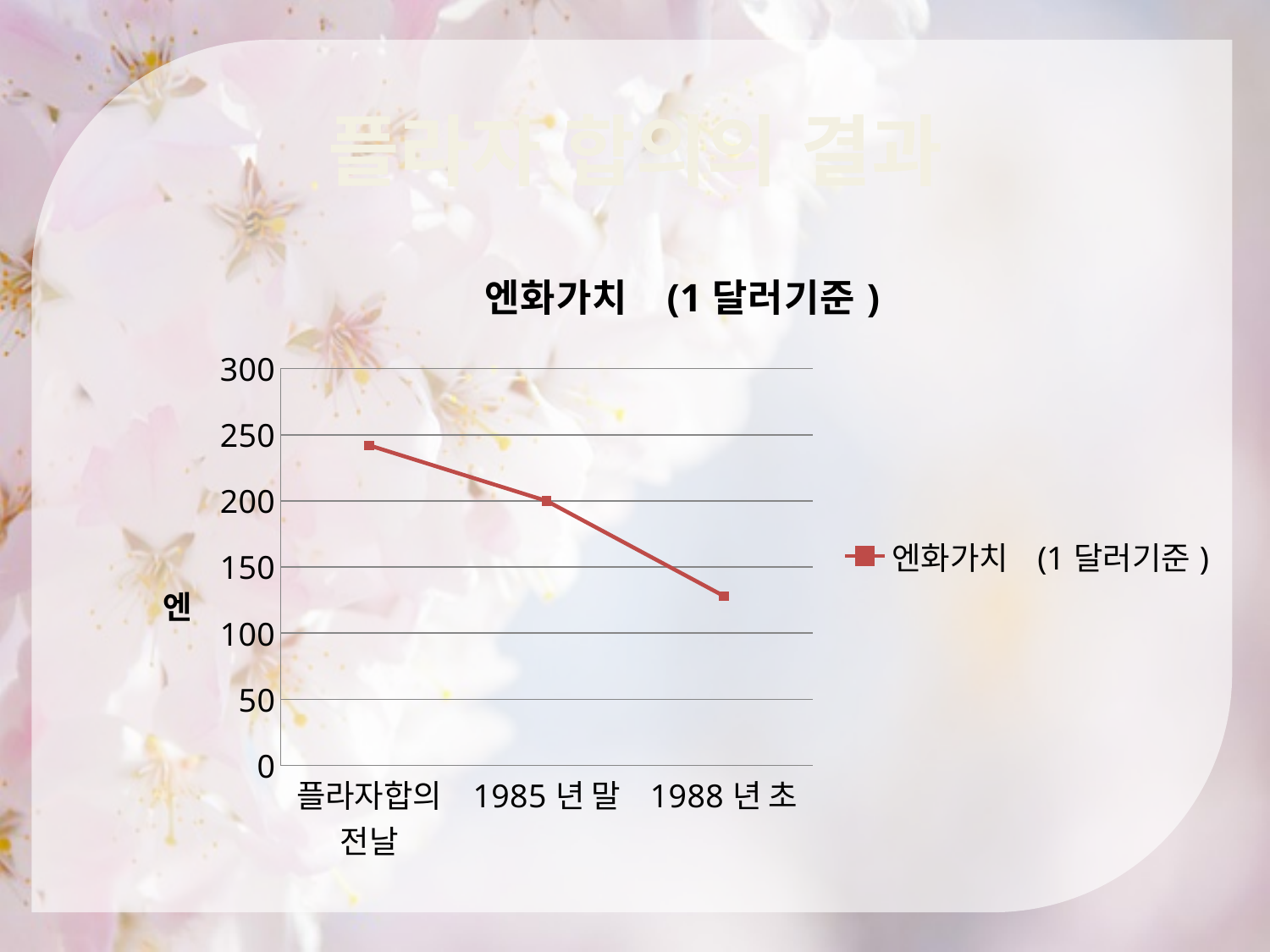
Do the values rise or fall from 플라자합의 전날 to 1988 년 초? fall Which category has the highest value? 플라자합의 전날 What is the title of the chart? 엔화가치 (1 달러기준 ) Which category has the lowest value? 1988 년 초 Is the value for 1988 년 초 greater or less than 100? greater Which is larger, the value for 플라자합의 전날 or the value for 1988 년 초? 플라자합의 전날 Is the value for 플라자합의 전날 greater or less than 250? less What is the label on the vertical axis of the chart? 엔 How many data points are plotted on the line? 3 Is the value for 1988 년 초 greater or less than 150? less How many series does the legend list? 1 What kind of chart is shown on the slide? line chart